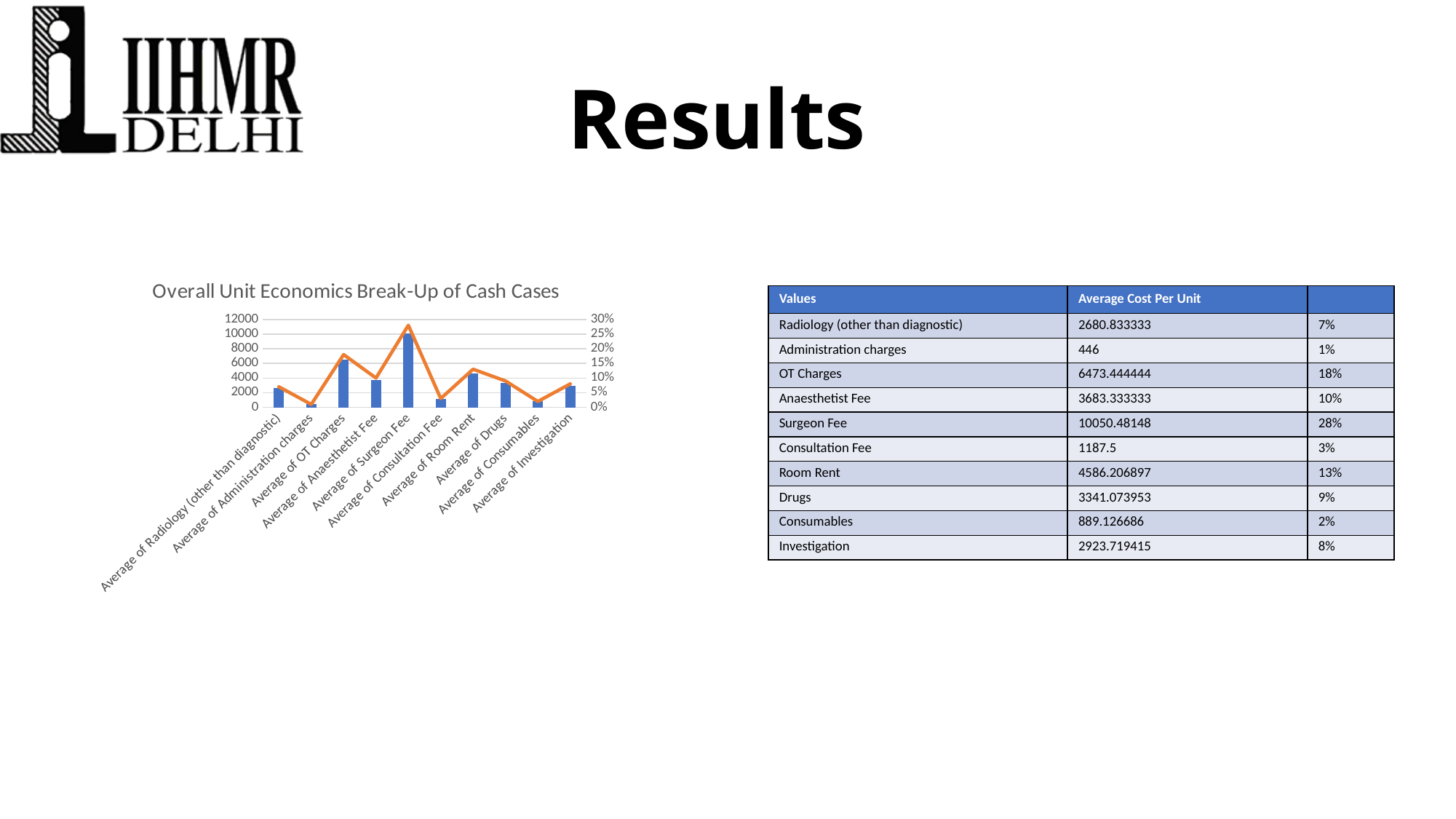
How many categories are plotted along the x axis of the chart? 10 Which category has the tallest bar in the chart? Average of Surgeon Fee Is the bar value for Average of Consultation Fee greater or less than 2000? less Which has the taller bar, Average of OT Charges or Average of Room Rent? Average of OT Charges Is the bar value for Average of Surgeon Fee greater or less than 8000? greater Is the bar value for Average of Anaesthetist Fee greater or less than 2000? greater Which has the taller bar, Average of Radiology (other than diagnostic) or Average of Consumables? Average of Radiology (other than diagnostic) What is the highest tick value shown on the right-hand (percentage) axis of the chart? 30% What is the title of the chart on the slide? Overall Unit Economics Break-Up of Cash Cases What kind of chart is shown on the slide? Bar chart with a line series